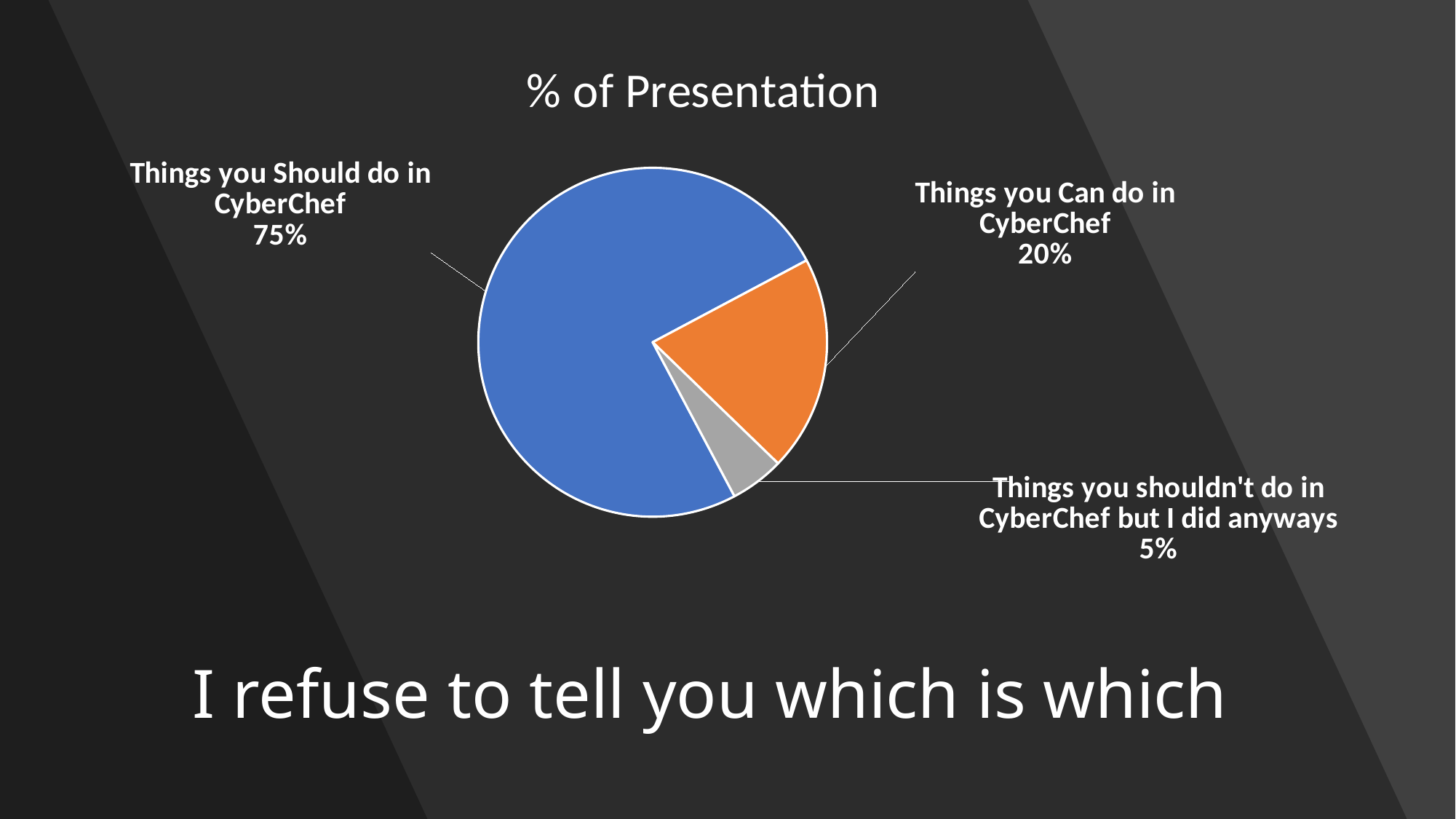
Which slice of the pie is the largest? Things you Should do in CyberChef What share of the pie is labelled "Things you shouldn't do in CyberChef but I did anyways"? 5% Which is larger: the share for "Things you Can do in CyberChef" or the share for "Things you shouldn't do in CyberChef but I did anyways"? Things you Can do in CyberChef What share of the pie is labelled "Things you Can do in CyberChef"? 20% What is the title of the chart? % of Presentation What kind of chart is shown on the slide? pie chart What share of the pie is labelled "Things you Should do in CyberChef"? 75% What is the combined share of "Things you Can do in CyberChef" and "Things you shouldn't do in CyberChef but I did anyways"? 25% How many slices does the pie chart have? 3 What is the difference between the "Things you Should do in CyberChef" share and the "Things you Can do in CyberChef" share? 55% Which slice of the pie is the smallest? Things you shouldn't do in CyberChef but I did anyways What colour is the slice for "Things you Can do in CyberChef"? orange